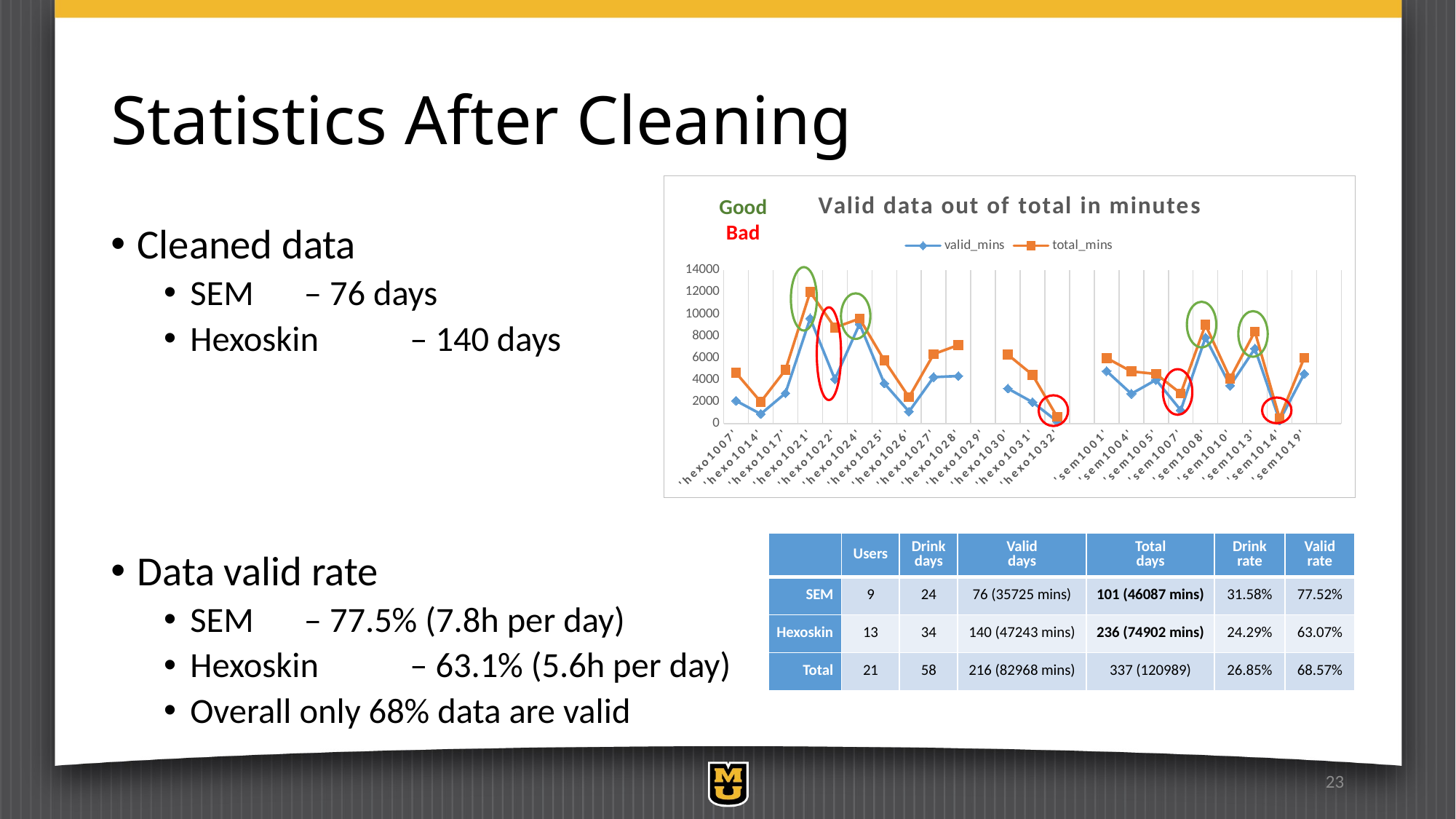
Is the valid_mins value for 'sem1008' greater or less than 6000? greater Which is larger, the valid_mins value for 'hexo1021' or for 'hexo1014'? 'hexo1021' Which is larger, the total_mins value for 'hexo1021' or for 'sem1008'? 'hexo1021' Is the total_mins value for 'hexo1032' greater or less than 2000? less What are the two series named in the chart's legend? valid_mins and total_mins Which category has the highest total_mins value in the chart? 'hexo1021' Is the valid_mins value for 'hexo1014' greater or less than 2000? less How many series does the chart's legend list? 2 How many category labels are shown along the x axis of the chart? 23 What is the title of the chart? Valid data out of total in minutes What kind of chart is shown on the slide? line chart